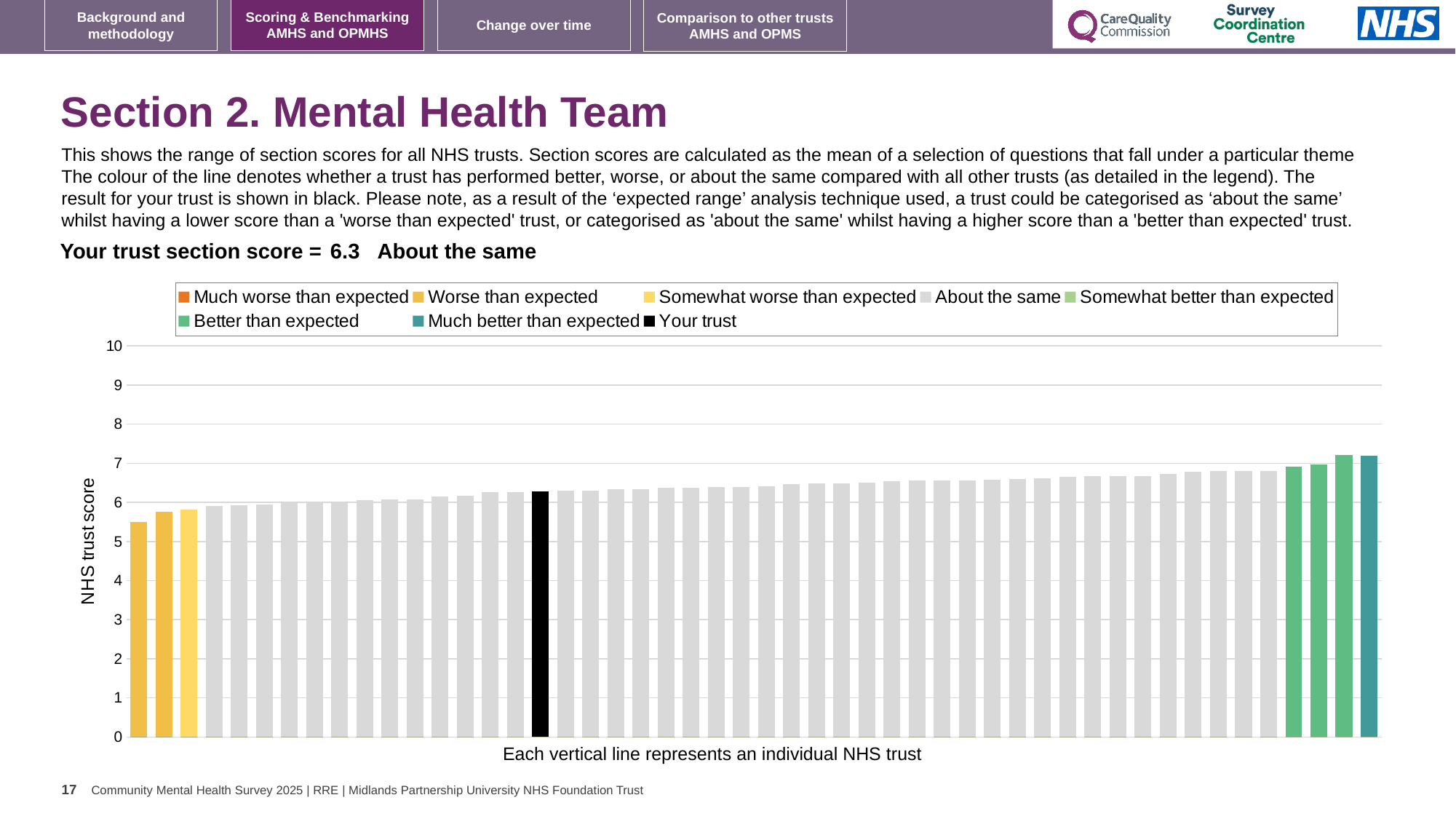
What kind of chart is shown on the slide? bar chart Which category is your trust placed in for Section 2. Mental Health Team? About the same How many bars are coloured as 'Worse than expected' (yellow) in the chart? 2 How many entries does the chart legend list? 8 Is the value of the black bar (your trust) greater or less than 5? greater Is the value of the leftmost (lowest) bar greater or less than 6? less Do the bar values rise or fall from left to right along the x axis? rise How many bars are coloured as 'Much better than expected' (teal) in the chart? 1 What colour is used for 'Your trust' in the chart legend? black What is the label on the vertical axis of the chart? NHS trust score Is the value of the black bar (your trust) greater or less than 7? less What is your trust's section score for Section 2. Mental Health Team? 6.3